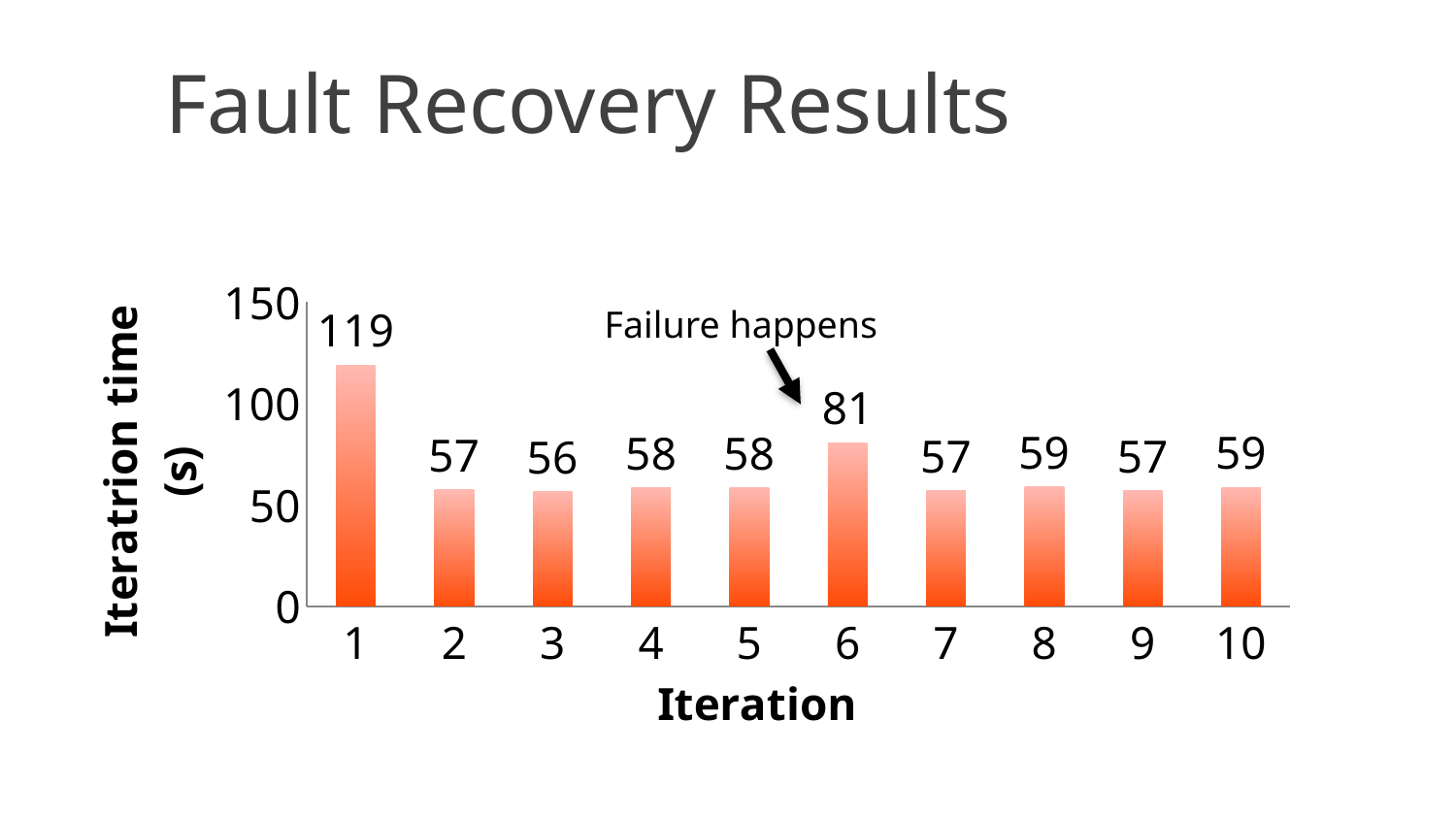
Which has a larger iteration time, iteration 6 or iteration 8? Iteration 6 What is the difference in iteration time between iteration 1 and iteration 2? 62 What is the iteration time for iteration 1? 119 What kind of chart is shown on the slide? Bar chart What is the iteration time for iteration 6? 81 Which iteration has the highest iteration time? 1 Which iteration has the lowest iteration time? 3 Is the value for iteration 1 greater or less than 100? greater How many iterations are shown on the x axis? 10 What is the difference in iteration time between iteration 6 and iteration 7? 24 According to the annotation, at which iteration does the failure happen? 6 What is the iteration time for iteration 3? 56